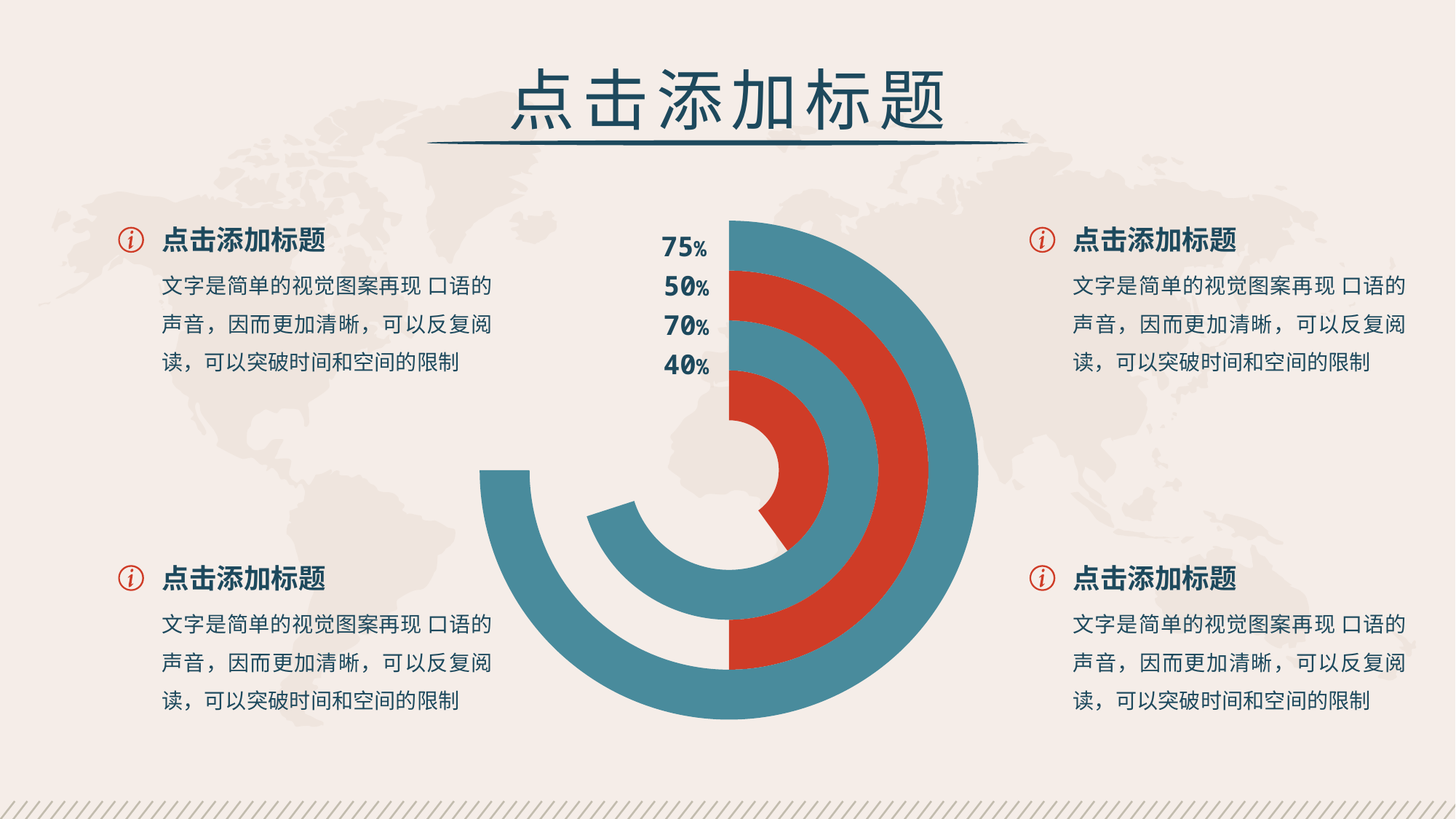
What value is labelled for the second ring from the outside? 50% What value is labelled for the third ring from the outside? 70% Which is larger, the value of the second ring from the outside or the third ring from the outside? the third ring (70%) What value is labelled for the outermost ring of the chart? 75% What is the difference between the highest value (75%) and the lowest value (40%)? 35% Which ring has the lowest value? the innermost ring (40%) What is the difference between the third ring (70%) and the second ring (50%)? 20% What kind of chart is shown in the centre of the slide? doughnut chart How many rings (data values) does the chart show? 4 Which ring has the highest value? the outermost ring (75%) What value is labelled for the innermost ring of the chart? 40% What colour is the outermost ring of the chart? teal blue